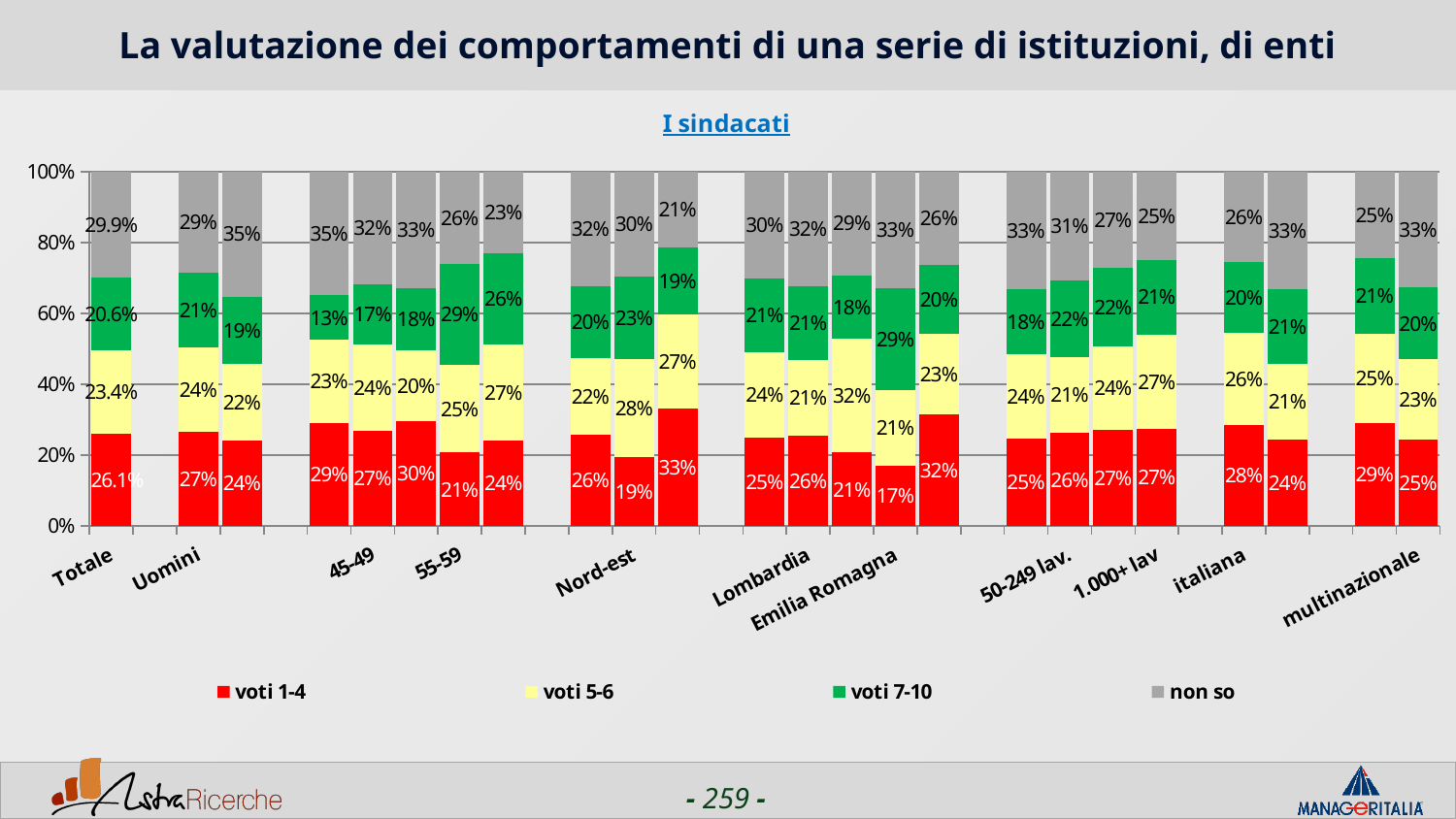
What is the value of 'non so' for Totale? 29.9% Which segment is the largest in the Totale bar? non so Which is larger for Uomini: 'voti 1-4' or 'voti 7-10'? voti 1-4 What is the value of 'voti 7-10' for Emilia Romagna? 29% What is the difference between 'voti 1-4' and 'voti 5-6' for Totale? 2.7% What is the value of 'voti 1-4' for Nord-est? 19% What is the value of 'voti 1-4' for Totale? 26.1% What is the value of 'non so' for multinazionale? 33% How many series does the legend list? 4 What is the subtitle of the chart? I sindacati What type of chart is shown on the slide? stacked bar chart What is the value of 'voti 5-6' for Uomini? 24%